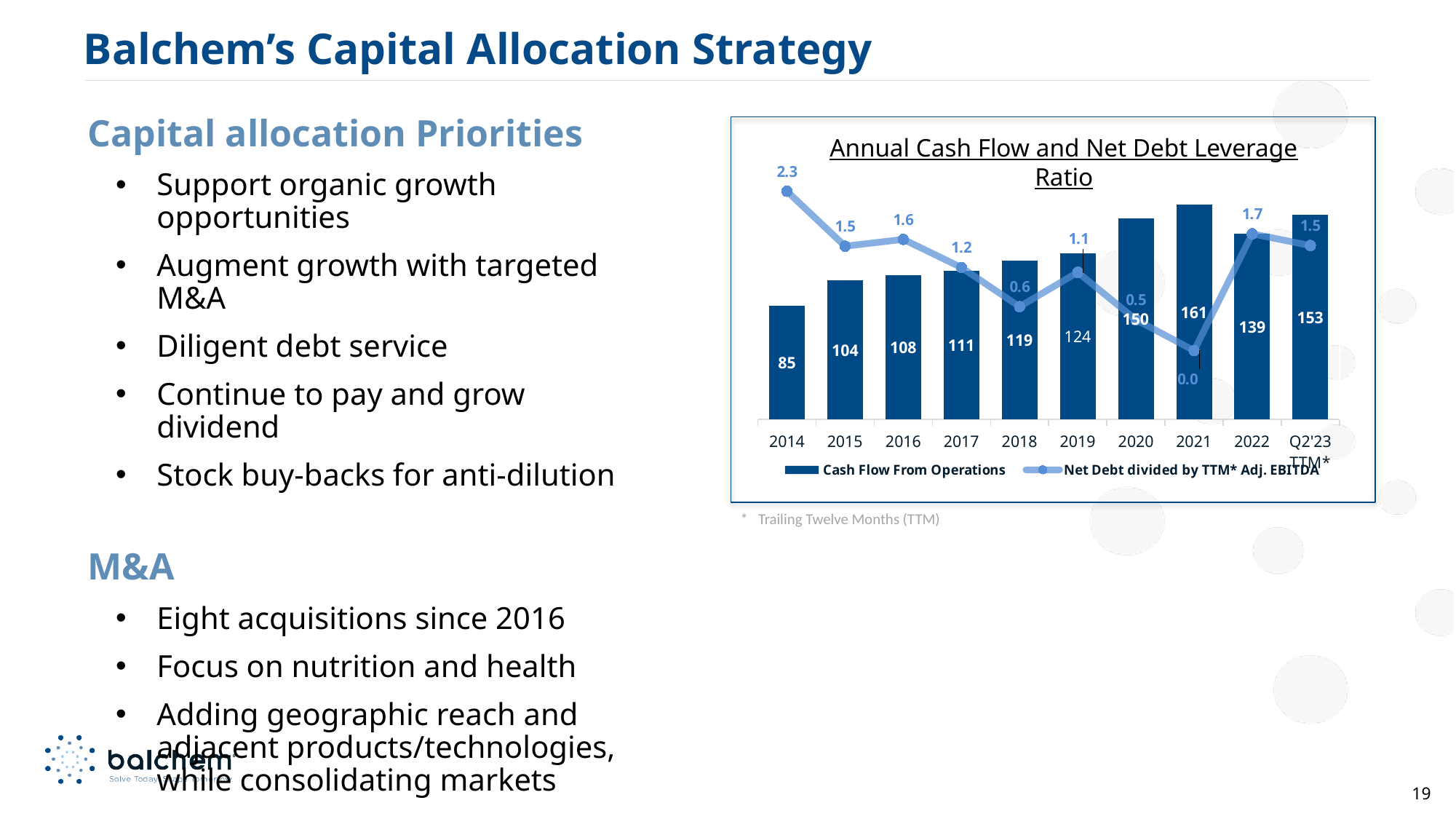
What is the title of the chart? Annual Cash Flow and Net Debt Leverage Ratio What is the difference in Cash Flow From Operations between 2021 and 2022? 22 What is the Net Debt divided by TTM Adj. EBITDA value for 2014? 2.3 What is the Net Debt divided by TTM Adj. EBITDA value for 2018? 0.6 What is the Cash Flow From Operations value for 2014? 85 What is the Cash Flow From Operations value for 2021? 161 How many series does the chart legend list? 2 Which is larger, the Cash Flow From Operations for 2020 or for Q2'23 TTM? Q2'23 TTM What kind of chart is used to show Cash Flow From Operations? Bar chart Which year has the lowest Net Debt divided by TTM Adj. EBITDA value? 2021 How many periods are shown on the x axis of the chart? 10 Which year has the highest Cash Flow From Operations? 2021